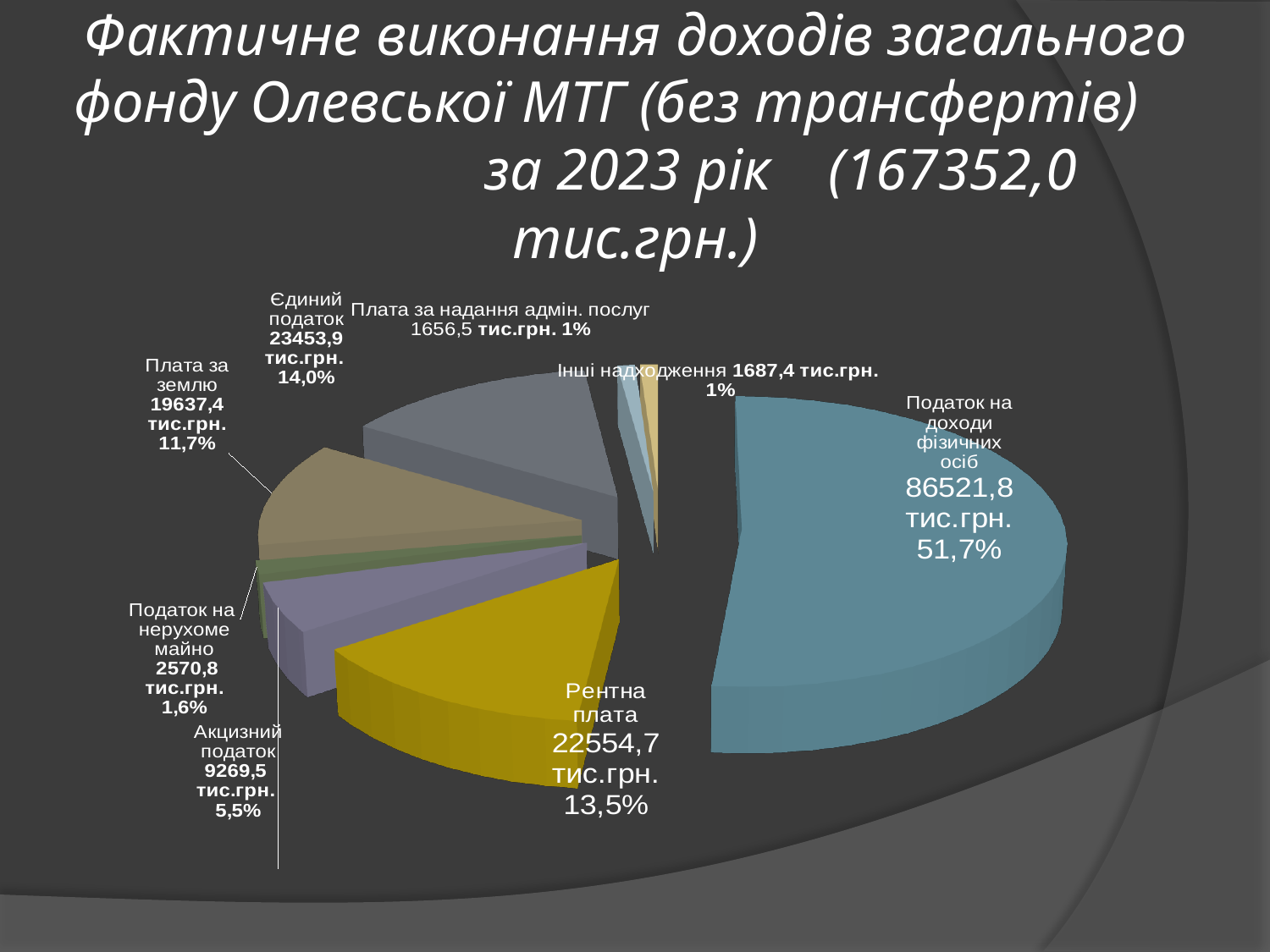
What is the value for Податок на доходи фізичних осіб? 86521,8 тис.грн. Which is larger, Єдиний податок or Рентна плата? Єдиний податок What is the value for Рентна плата? 22554,7 тис.грн. How many slices does the pie chart have? 8 Which category has the largest slice of the pie? Податок на доходи фізичних осіб What is the difference between the values for Єдиний податок and Плата за землю? 3816,5 тис.грн. What kind of chart is shown on the slide? Pie chart What share of the pie does Плата за землю represent? 11,7% What is the value for Акцизний податок? 9269,5 тис.грн. What share of the pie does Єдиний податок represent? 14,0% Which category has the smallest value in the pie chart? Плата за надання адмін. послуг What total amount is given in the chart title for 2023? 167352,0 тис.грн.